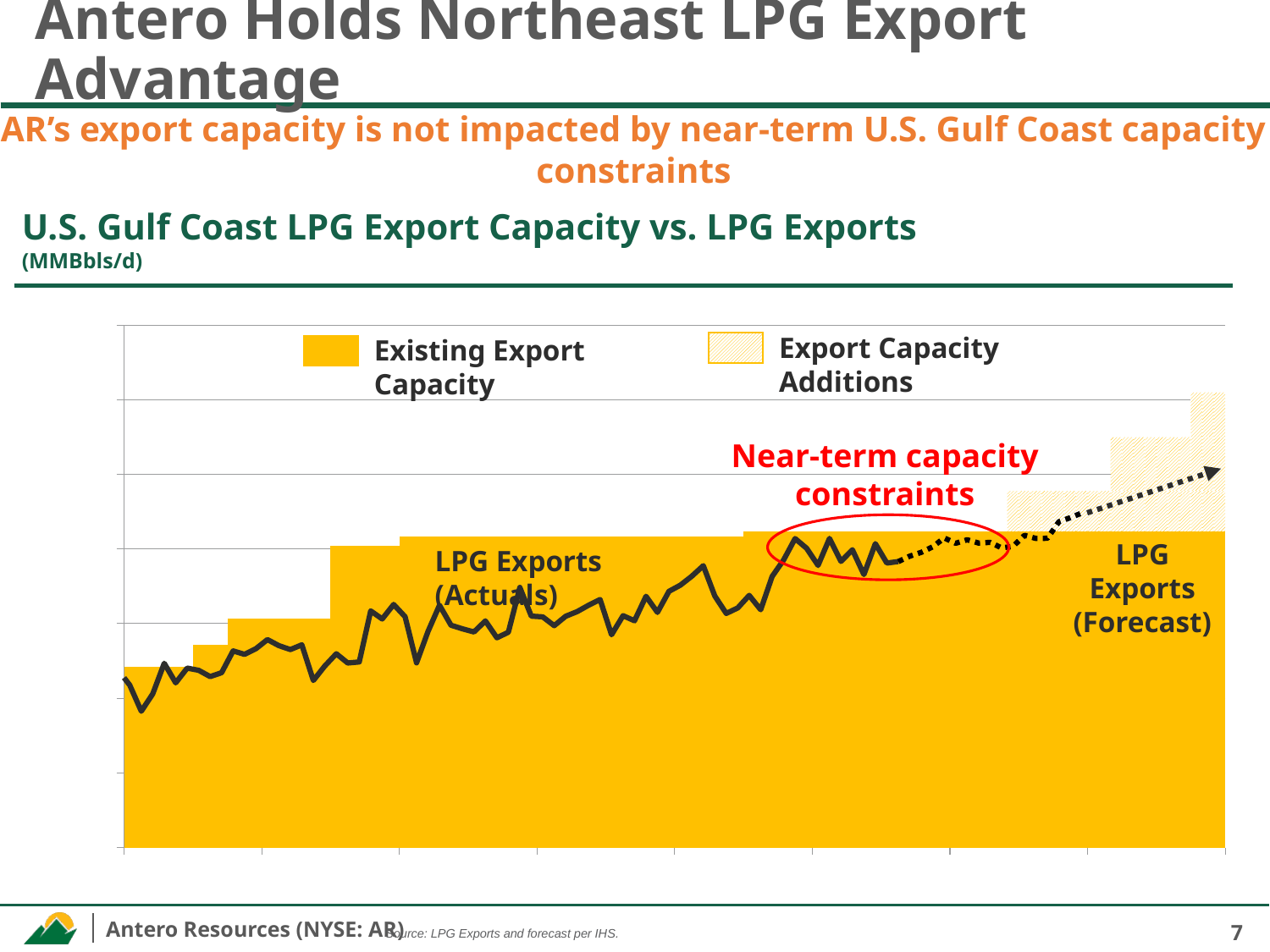
What unit is the chart measured in? MMBbls/d What is the title of the chart? U.S. Gulf Coast LPG Export Capacity vs. LPG Exports What kind of chart is shown on the slide? combination bar and line chart (stacked bars with a line overlay) Does the LPG Exports (Forecast) dotted line rise or fall along the x axis? rise Do the LPG Exports (Actuals) values generally rise or fall along the x axis? rise Does the Existing Export Capacity area rise or fall along the x axis? rise How many series does the legend list? 2